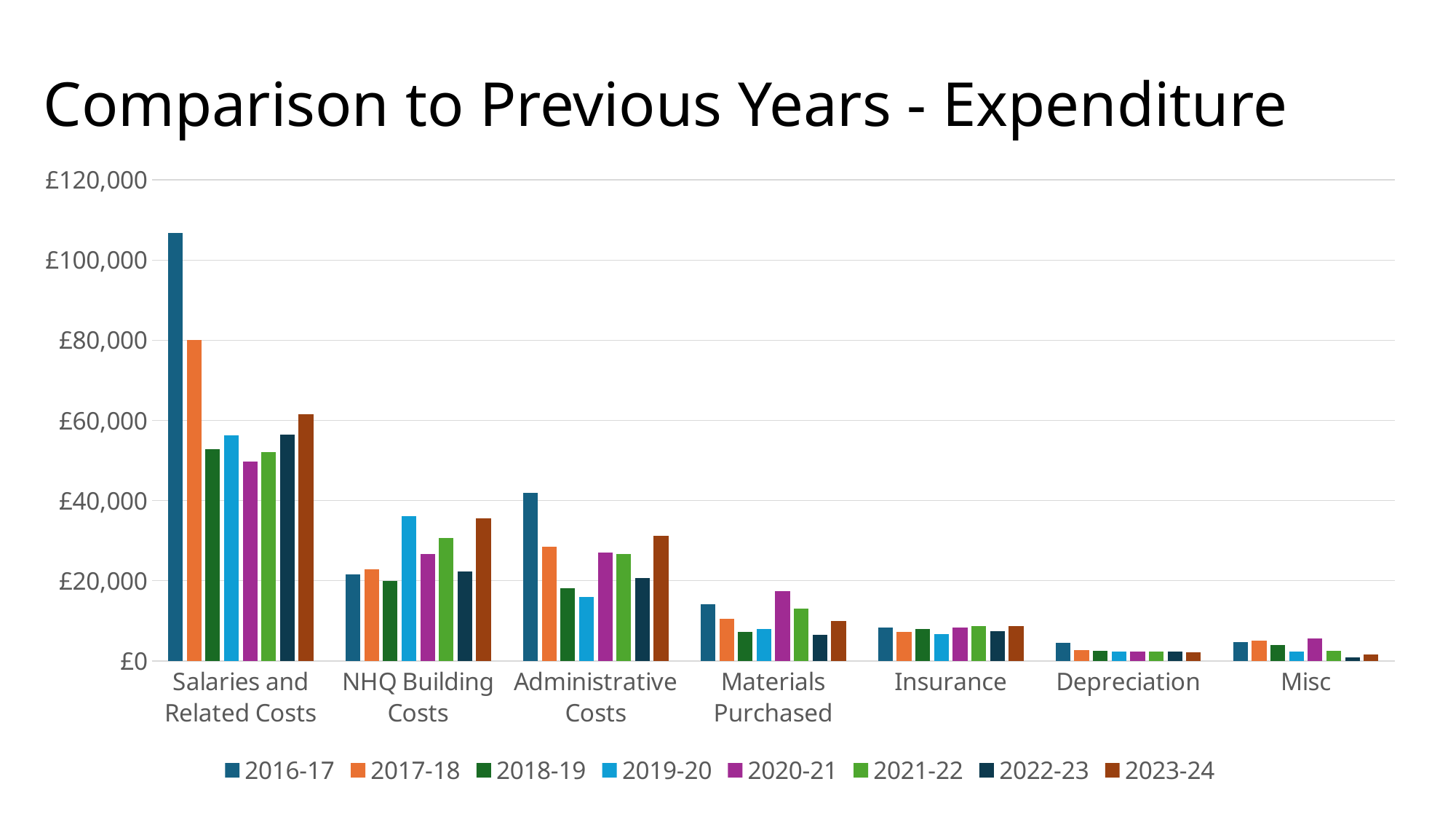
For NHQ Building Costs, which is larger: the 2019-20 value or the 2018-19 value? 2019-20 How many expenditure categories are shown on the x axis? 7 Which category has the highest 2016-17 expenditure? Salaries and Related Costs Which year has the lowest value for Misc? 2022-23 Is the 2016-17 value for Administrative Costs greater or less than £40,000? greater Which year has the highest value for Materials Purchased? 2020-21 Is the 2016-17 value for Salaries and Related Costs greater or less than £100,000? greater Is the 2017-18 value for Salaries and Related Costs greater or less than £60,000? greater Moving from left to right across the categories, do the 2016-17 values generally rise or fall? fall What kind of chart is shown on the slide? bar chart How many series does the legend list? 8 For Administrative Costs, which is larger: the 2016-17 value or the 2023-24 value? 2016-17